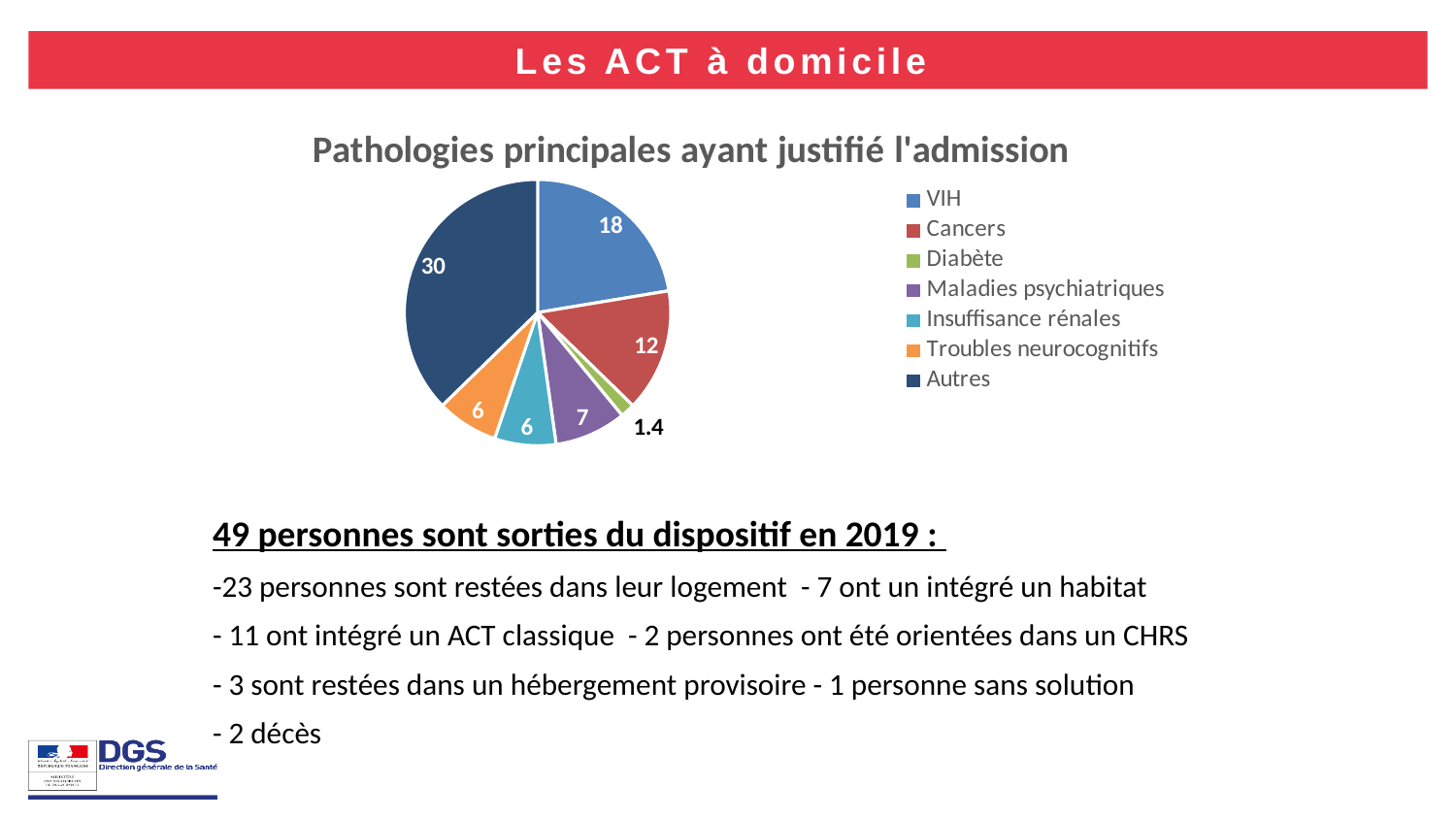
What is the title of the chart? Pathologies principales ayant justifié l'admission What is the value shown for Cancers? 12 What is the difference between the values for Autres and VIH? 12 Which is larger, the value for VIH or the value for Cancers? VIH What is the value shown for Diabète? 1.4 How many categories does the legend list? 7 Which category has the largest slice of the pie? Autres What is the value shown for Maladies psychiatriques? 7 Which category has the smallest slice of the pie? Diabète What type of chart is shown on the slide? Pie chart What is the value shown for VIH? 18 What is the value shown for Autres? 30